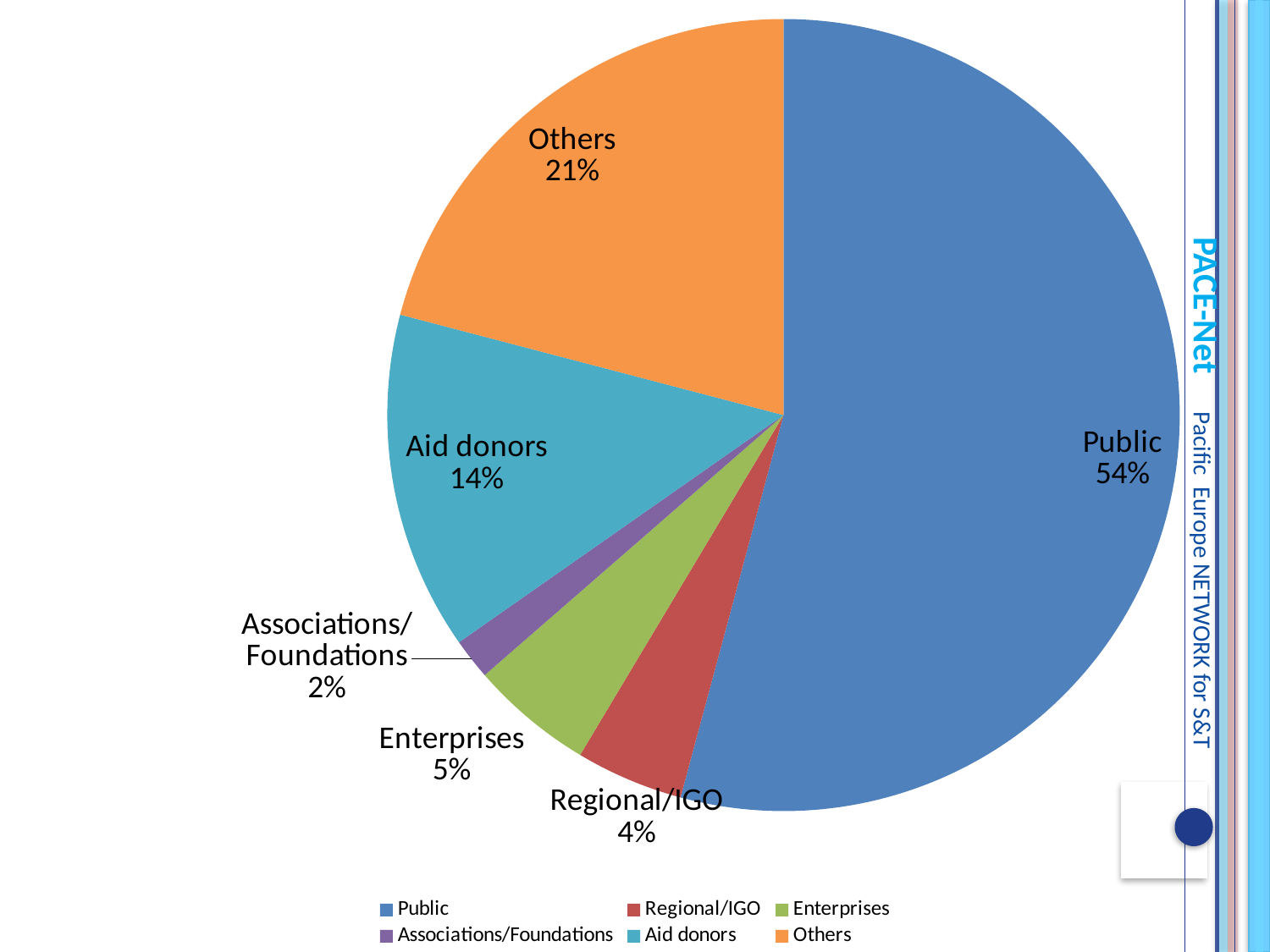
What kind of chart is shown on the slide? pie chart What is the value shown for Aid donors? 14% How many categories are shown in the pie chart? 6 What is the value shown for Enterprises? 5% What is the value shown for Others? 21% What colour is the Aid donors slice? teal What is the difference between the Others share and the Aid donors share? 7% Which category has the smallest slice of the pie? Associations/Foundations Which category has the largest slice of the pie? Public Which is larger, Enterprises or Regional/IGO? Enterprises What share of the pie does Public account for? 54% What is the value shown for Associations/Foundations? 2%